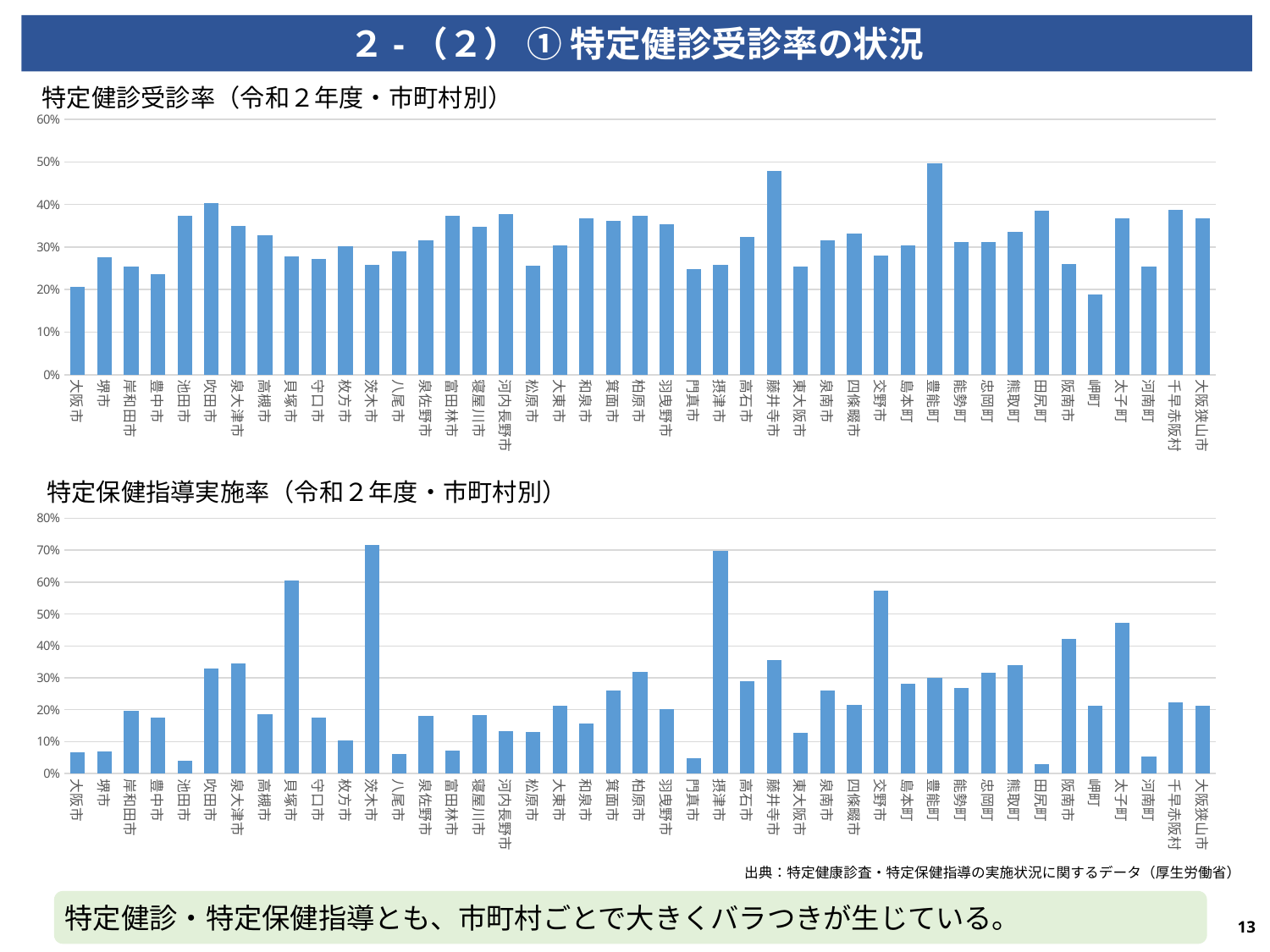
In the bottom chart, 特定保健指導実施率（令和２年度・市町村別）, is the value for 田尻町 greater or less than 10%? less In the top chart, 特定健診受診率（令和２年度・市町村別）, which has the higher value, 豊能町 or 大阪市? 豊能町 What is the title of the top chart on the slide? 特定健診受診率（令和２年度・市町村別） In the top chart, 特定健診受診率（令和２年度・市町村別）, is the value for 大阪市 greater or less than 30%? less In the top chart, 特定健診受診率（令和２年度・市町村別）, is the value for 岬町 greater or less than 20%? less In the top chart, 特定健診受診率（令和２年度・市町村別）, how many municipalities are shown on the x axis? 43 What kind of chart is the top chart, 特定健診受診率（令和２年度・市町村別）? bar chart In the bottom chart, 特定保健指導実施率（令和２年度・市町村別）, which has the higher value, 茨木市 or 八尾市? 茨木市 In the bottom chart, 特定保健指導実施率（令和２年度・市町村別）, what is the highest value shown on the y axis? 80%